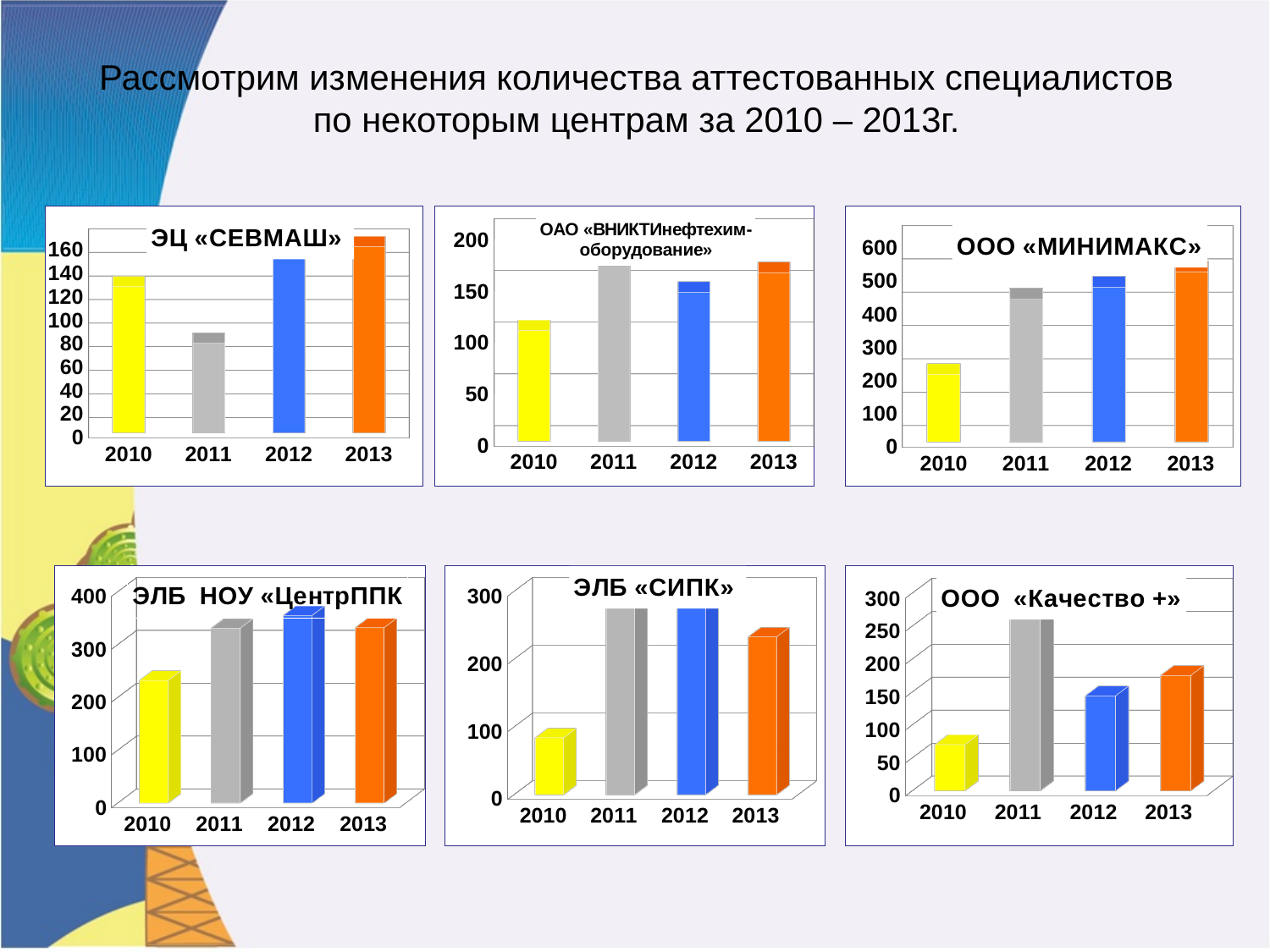
In the ООО «МИНИМАКС» chart, which year has the highest value? 2013 In the ЭЦ «СЕВМАШ» chart, which year has the highest value? 2013 In the ЭЛБ НОУ «ЦентрППК» chart, which year has the lowest value? 2010 In the ЭЛБ «СИПК» chart, is the value for 2010 greater or less than 100? less In the ООО «МИНИМАКС» chart, is the value for 2010 greater or less than 300? less In the ОАО «ВНИКТИнефтехим-оборудование» chart, which year has the lowest value? 2010 In the ЭЦ «СЕВМАШ» chart, is the value for 2011 greater or less than 100? less In the ЭЦ «СЕВМАШ» chart, which year has the lowest value? 2011 In the ООО «Качество +» chart, which is larger, the value for 2012 or the value for 2013? 2013 In the ООО «Качество +» chart, which year has the highest value? 2011 How many years are shown on the x axis of the ЭЛБ «СИПК» chart? 4